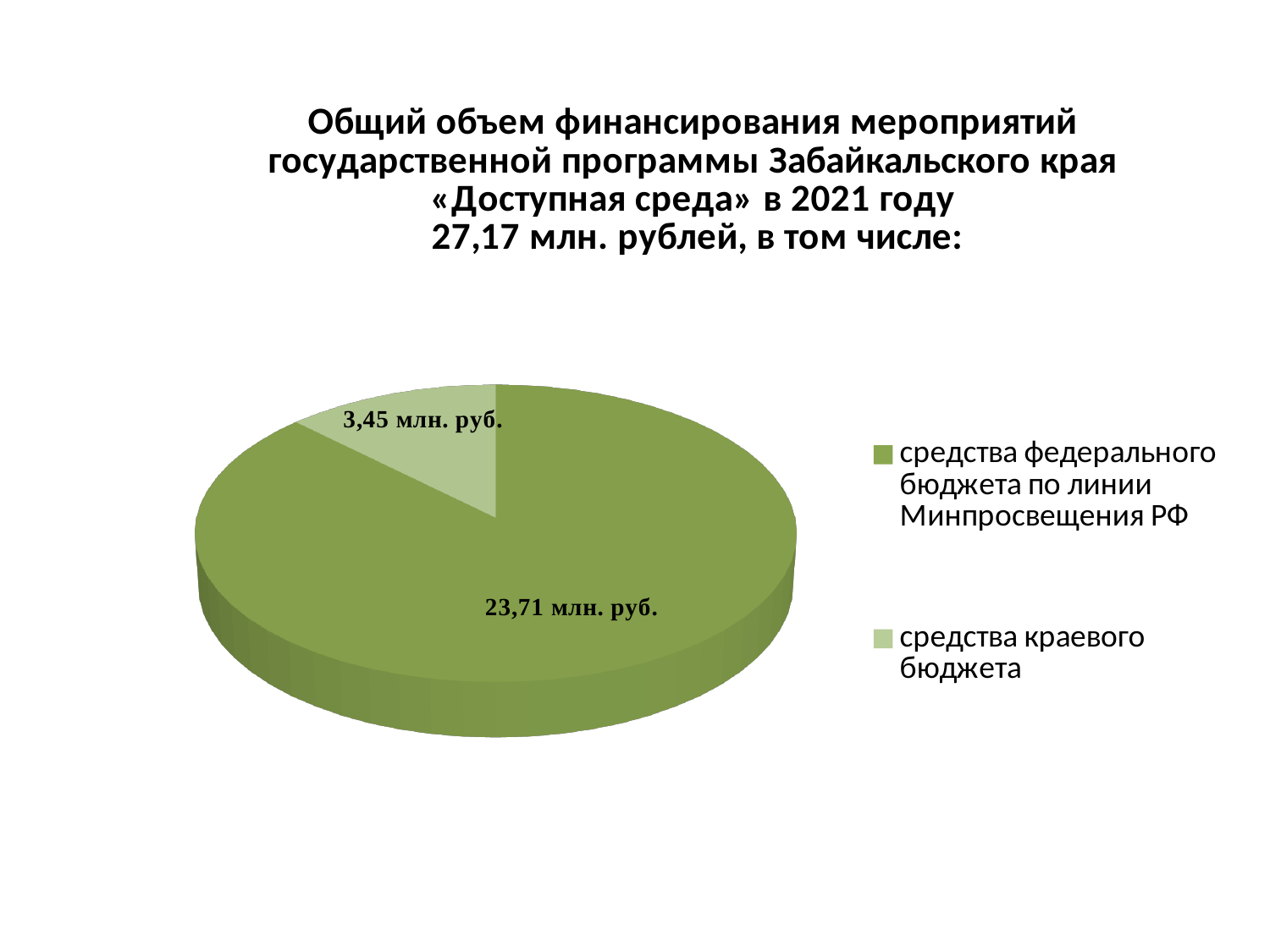
Which category has the largest slice of the pie? средства федерального бюджета по линии Минпросвещения РФ What is the difference between the federal budget funds and the regional budget funds? 20,26 млн. руб. How many entries does the legend list? 2 What is the value for «средства федерального бюджета по линии Минпросвещения РФ»? 23,71 млн. руб. According to the slide title, what is the total funding volume of the programme in 2021? 27,17 млн. рублей What kind of chart is shown on the slide? Pie chart Which is larger: the federal budget funds or the regional (краевого) budget funds? средства федерального бюджета по линии Минпросвещения РФ How many slices does the pie chart have? 2 Which legend entry is shown in the lighter green colour? средства краевого бюджета Which category has the smallest slice of the pie? средства краевого бюджета What is the value for «средства краевого бюджета»? 3,45 млн. руб.